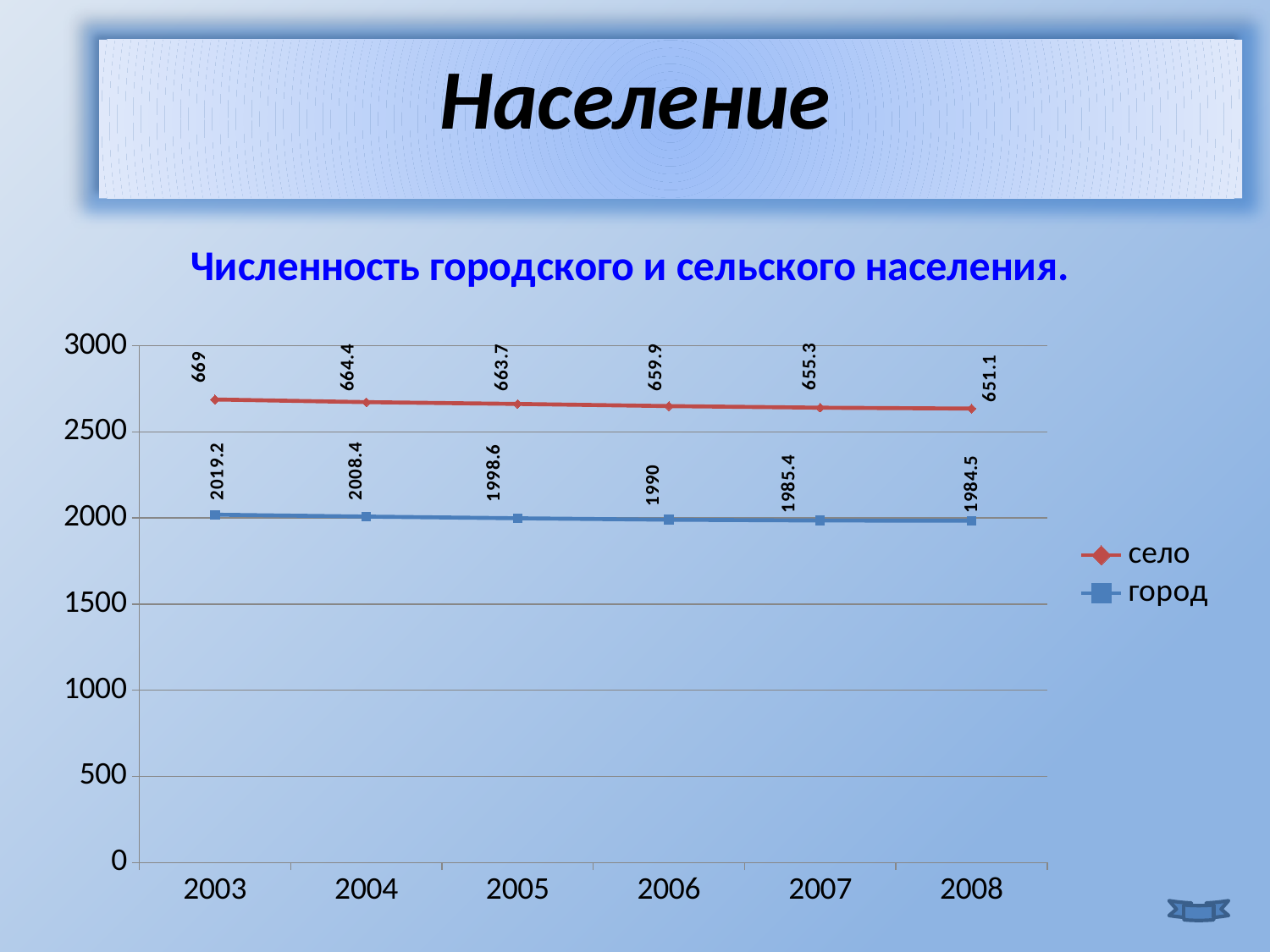
How many series does the legend list? 2 How many years are shown on the x axis? 6 What is the value for город in 2005? 1998.6 What is the value for город in 2006? 1990 What is the value for село in 2008? 651.1 In which year is the value for село lowest? 2008 What is the difference between the село values for 2003 and 2008? 17.9 What kind of chart is shown on the slide? line chart What is the difference between the город values for 2003 and 2008? 34.7 What is the value for село in 2003? 669 In which year is the value for город highest? 2003 Which is larger, the город value for 2004 or the город value for 2007? 2004